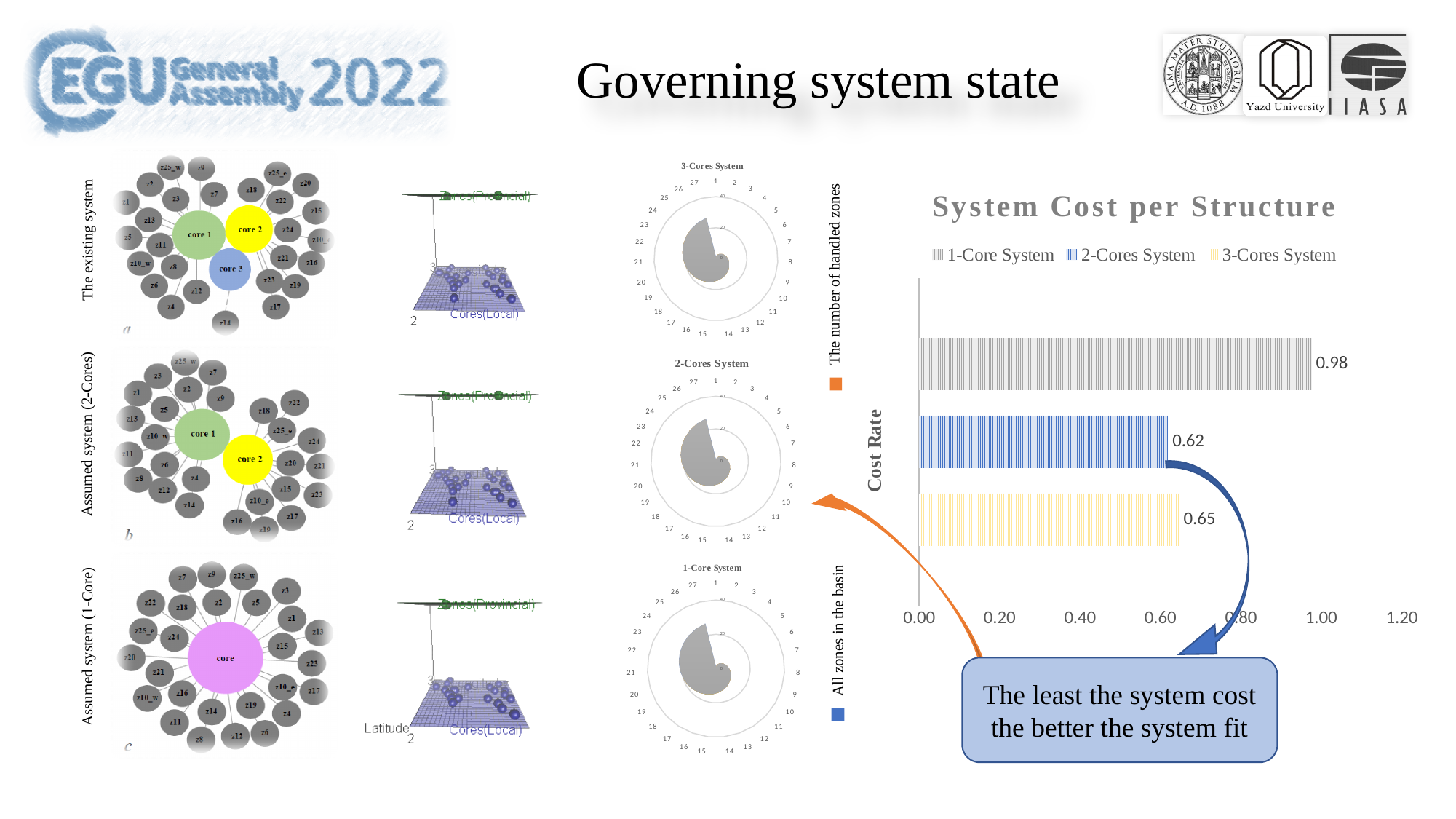
In the 'System Cost per Structure' chart, which is larger, the value for the 1-Core System or the 3-Cores System? 1-Core System What kind of chart is 'System Cost per Structure'? bar chart In the 'System Cost per Structure' chart, what is the value for the 1-Core System? 0.98 In the 'System Cost per Structure' chart, what is the value for the 2-Cores System? 0.62 In the 'System Cost per Structure' chart, what is the difference between the 3-Cores System and the 2-Cores System values? 0.03 In the 'System Cost per Structure' chart, what is the value for the 3-Cores System? 0.65 In the 'System Cost per Structure' chart, what is the difference between the 1-Core System and the 2-Cores System values? 0.36 What is the label on the vertical axis of the 'System Cost per Structure' chart? Cost Rate How many series does the legend of the 'System Cost per Structure' chart list? 3 In the 'System Cost per Structure' chart, which system has the highest cost rate? 1-Core System In the 'System Cost per Structure' chart, is the value for the 2-Cores System greater or less than 0.80? less In the 'System Cost per Structure' chart, which system has the lowest cost rate? 2-Cores System